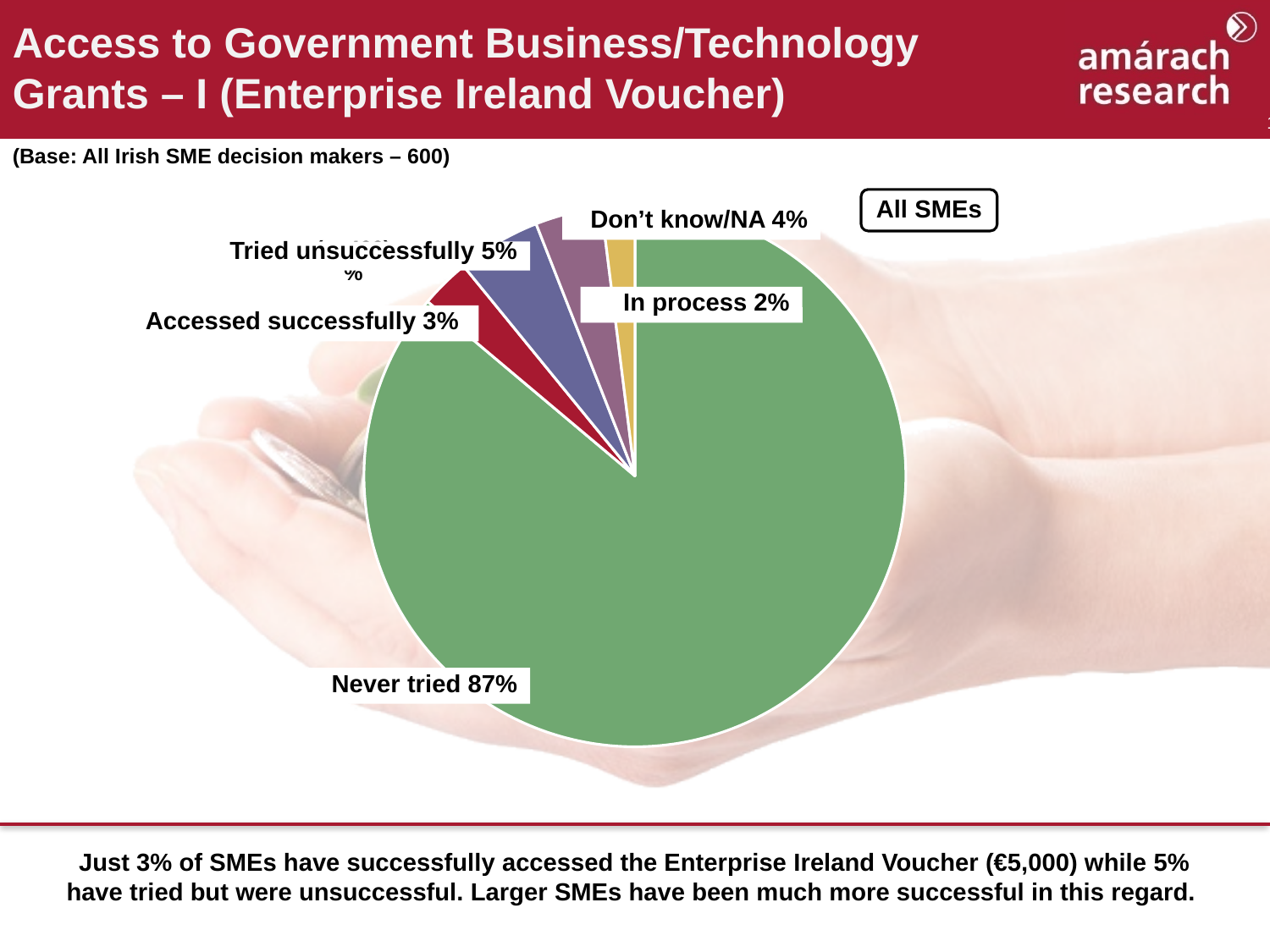
Which category has the largest share of the pie? Never tried Which category has the smallest share of the pie? In process What percentage of SMEs are in process of accessing the voucher? 2% What percentage of SMEs accessed the Enterprise Ireland Voucher successfully? 3% Which is larger: the share for Don't know/NA or the share for Accessed successfully? Don't know/NA What is the difference in percentage points between Tried unsuccessfully and Accessed successfully? 2 What is the base size stated for the chart? 600 How many categories are shown in the pie chart? 5 What kind of chart is shown on the slide? Pie chart What percentage of SMEs tried unsuccessfully to access the voucher? 5% What percentage of SMEs answered Don't know/NA? 4% What percentage of SMEs have never tried to access the Enterprise Ireland Voucher? 87%